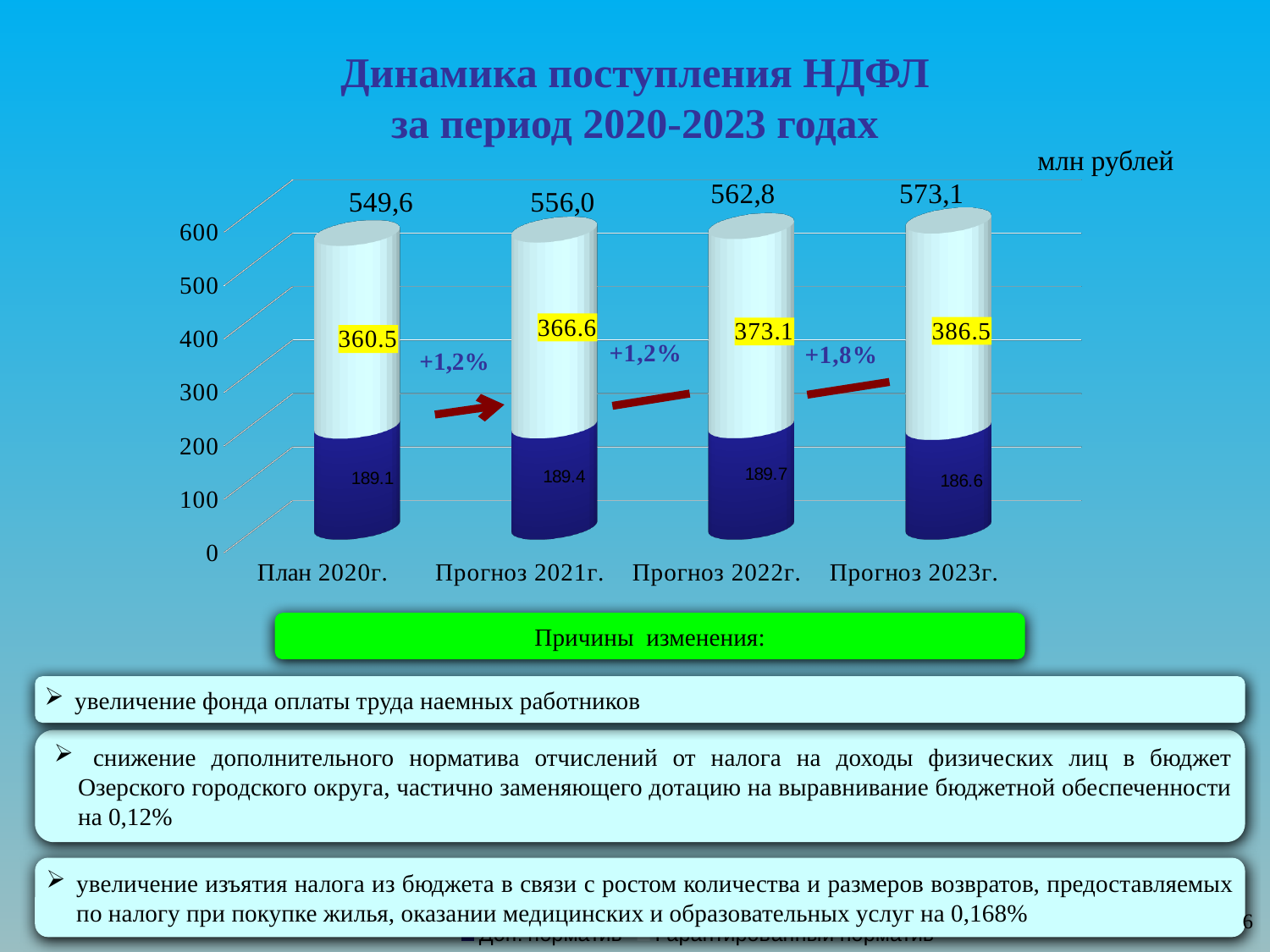
What is the total value shown above the bar for План 2020г.? 549,6 Do the total values rise or fall from План 2020г. to Прогноз 2023г.? rise What kind of chart is shown on the slide? bar chart Which category has the lowest value for the dark blue segment? Прогноз 2023г. By how much does the light upper segment for Прогноз 2023г. exceed that for План 2020г.? 26.0 How many categories are shown on the x axis? 4 Which is larger, the light upper segment for Прогноз 2021г. or for Прогноз 2022г.? Прогноз 2022г. Which category has the highest total value? Прогноз 2023г. What is the value of the dark blue segment for Прогноз 2022г.? 189.7 What percentage change is labelled between Прогноз 2022г. and Прогноз 2023г.? +1,8% Is the total value for Прогноз 2021г. greater or less than 500? greater What is the value of the light upper segment for Прогноз 2023г.? 386.5